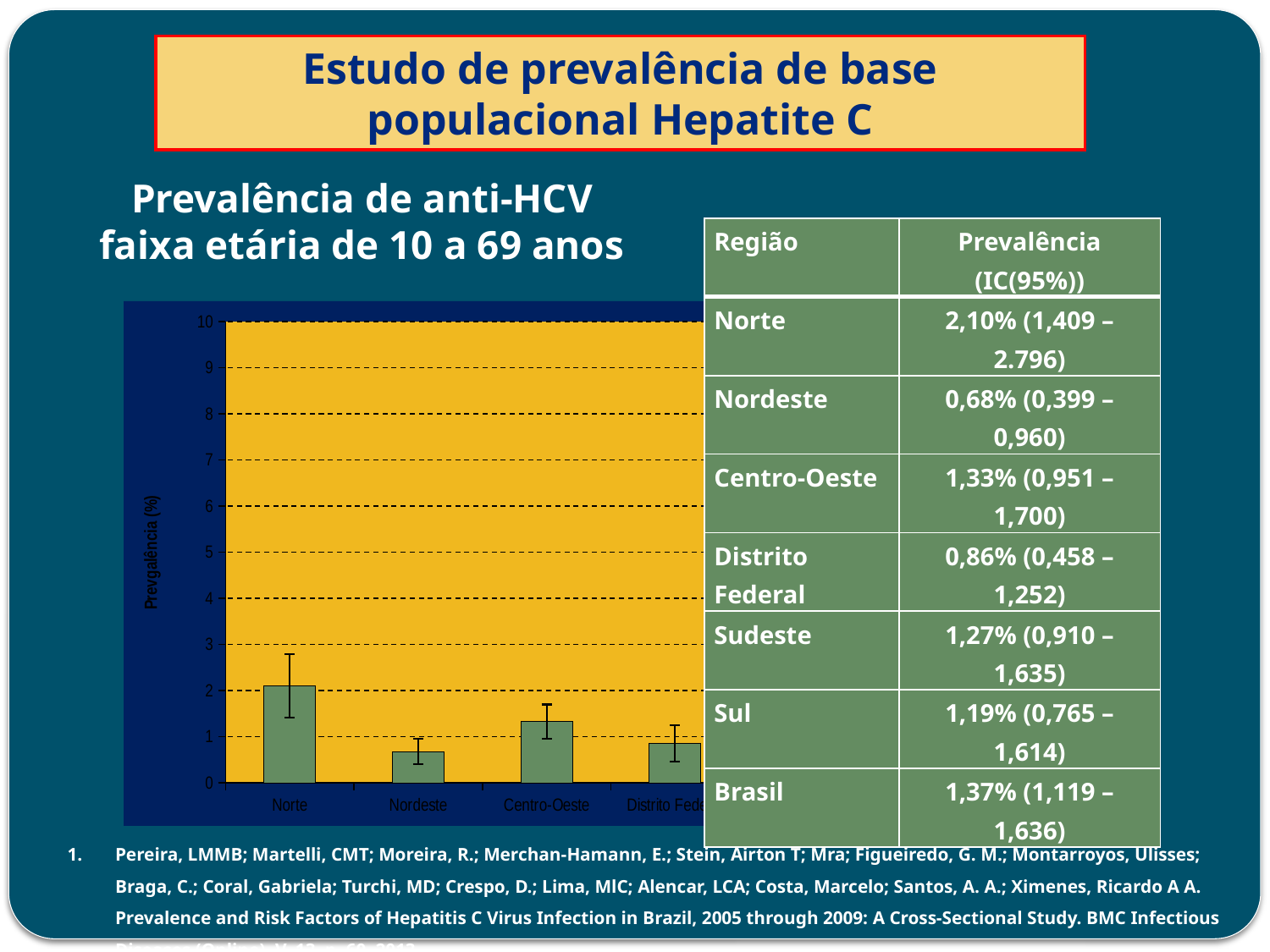
According to the table, what is the anti-HCV prevalence for Brasil? 1,37% What is the label of the y axis of the bar chart? Prevalência (%) Among the bars visible in the chart, which region has the lowest prevalence? Nordeste What kind of chart is shown on the slide? bar chart In the bar chart, which bar is taller, Norte or Nordeste? Norte According to the table, what is the anti-HCV prevalence for Norte? 2,10% What is the title above the bar chart? Prevalência de anti-HCV faixa etária de 10 a 69 anos In the bar chart, is the bar for Norte greater or less than 1? greater In the bar chart, is the bar for Nordeste greater or less than 1? less In the bar chart, is the bar for Norte greater or less than 3? less In the bar chart, which bar is taller, Centro-Oeste or Nordeste? Centro-Oeste Among the bars visible in the chart, which region has the highest prevalence? Norte